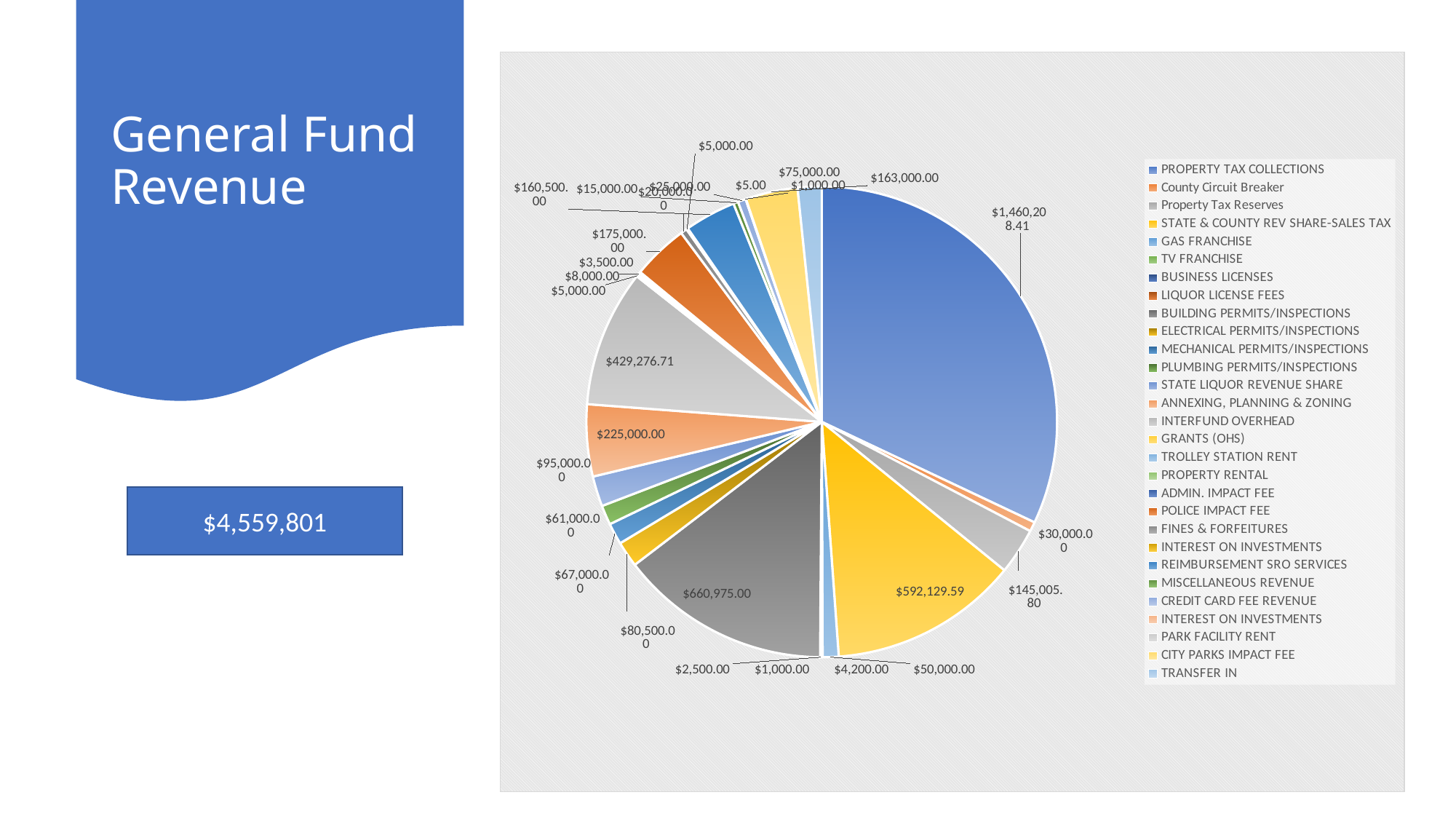
What is the title of the slide containing the chart? General Fund Revenue What is the difference between the PROPERTY TAX COLLECTIONS value and the BUILDING PERMITS/INSPECTIONS value? $799,233.41 Which revenue category has the largest slice in the pie chart? PROPERTY TAX COLLECTIONS What is the value of the largest slice in the pie chart? $1,460,208.41 What is the smallest value labelled on the pie chart? $5.00 What is the value shown for STATE & COUNTY REV SHARE-SALES TAX? $592,129.59 How many entries does the chart's legend list? 29 What is the value shown for BUILDING PERMITS/INSPECTIONS? $660,975.00 Which is larger, the BUILDING PERMITS/INSPECTIONS slice or the STATE & COUNTY REV SHARE-SALES TAX slice? BUILDING PERMITS/INSPECTIONS What total amount is shown in the box below the slide title? $4,559,801 What is the value shown for INTERFUND OVERHEAD? $429,276.71 What type of chart is shown on the slide? Pie chart